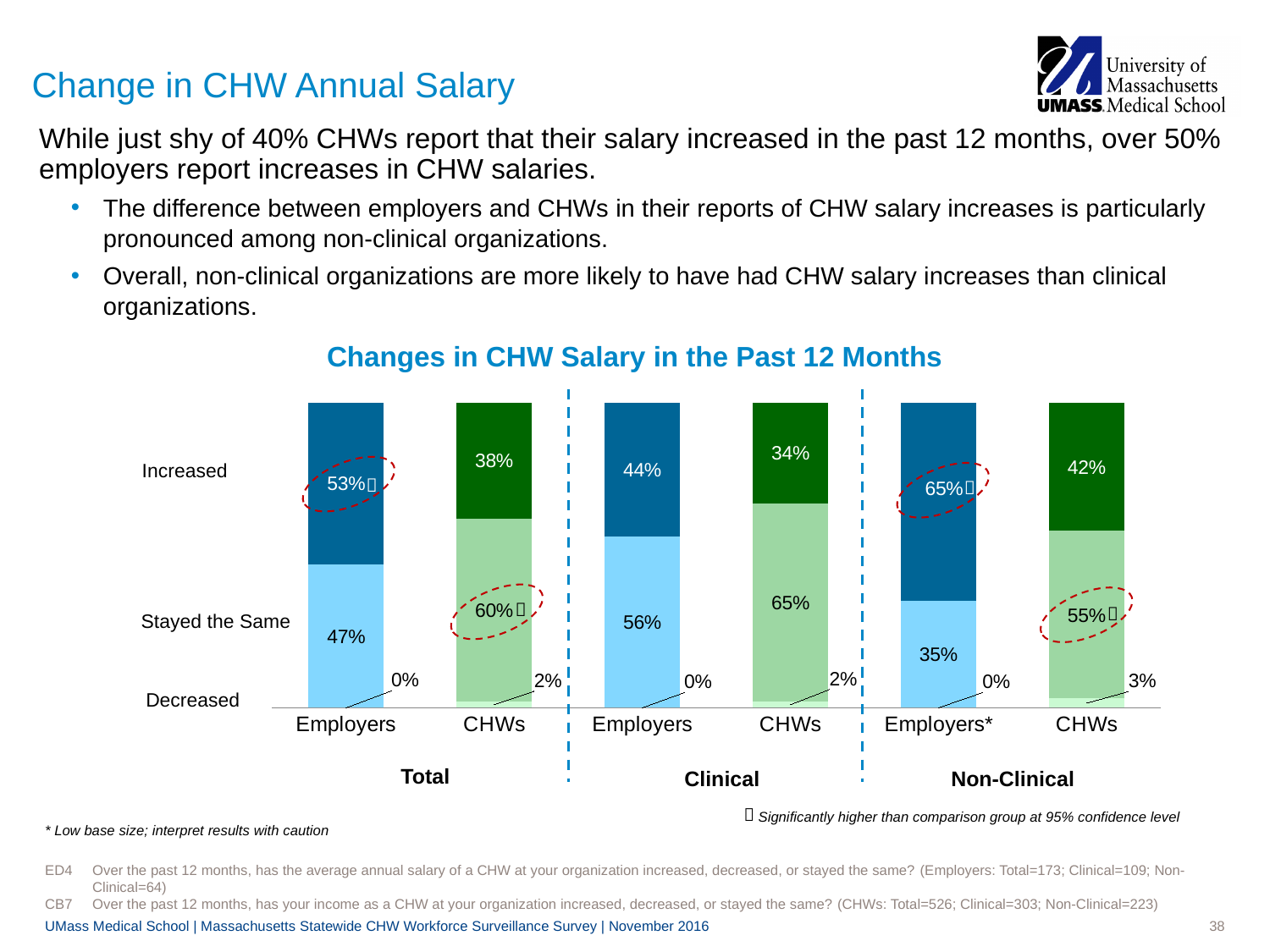
What percentage of Employers in the Non-Clinical group reported that CHW salary increased? 65% Which is larger: the 'Stayed the Same' percentage for Employers in the Clinical group or for Employers in the Non-Clinical group? Employers in the Clinical group Which bar has the lowest 'Increased' percentage? CHWs (Clinical) What type of chart is shown on the slide? stacked bar chart How many bars are shown in the chart? 6 What percentage of CHWs in the Non-Clinical group reported that their salary decreased? 3% What is the difference between the 'Increased' percentage for Employers and for CHWs in the Non-Clinical group? 23 percentage points What percentage of CHWs in the Clinical group reported that their salary increased? 34% What percentage of Employers in the Total group reported that CHW salary increased? 53% What is the title of the chart? Changes in CHW Salary in the Past 12 Months Which bar has the highest 'Increased' percentage? Employers* (Non-Clinical) What percentage of CHWs in the Total group reported that their salary stayed the same? 60%